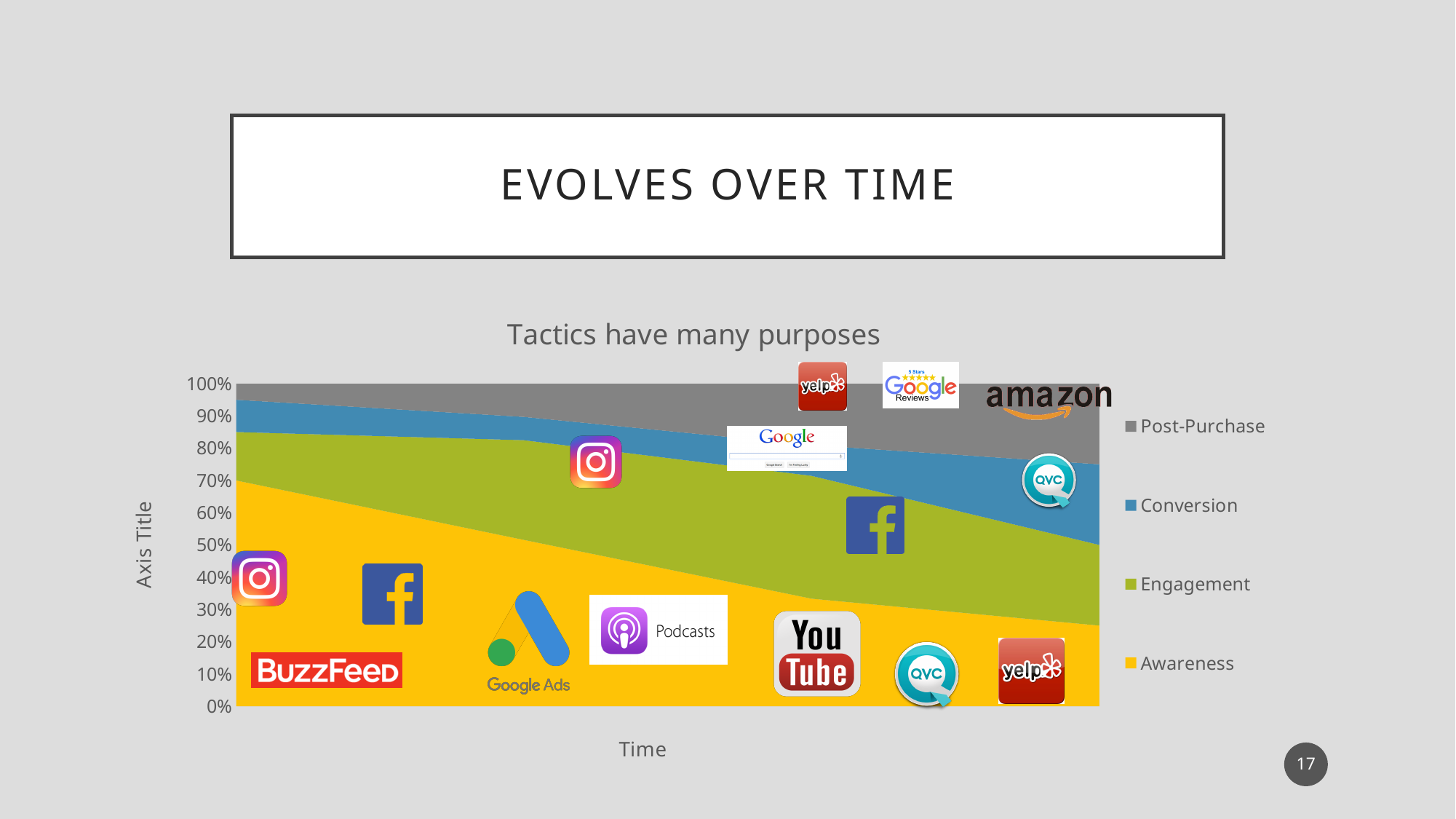
Does the Conversion share rise or fall as you move along the x axis? Rise At the left edge of the chart, is the Awareness share greater or less than 60%? greater At the right edge of the chart, is the Awareness share greater or less than 30%? less Does the Post-Purchase share rise or fall as you move along the x axis? Rise How many series does the chart's legend list? 4 What is the label on the horizontal axis of the chart? Time Does the Awareness share rise or fall as you move along the x axis? Fall At the left edge of the chart, which series has the smallest share? Post-Purchase What kind of chart is shown on the slide? Stacked area chart What is the title of the chart? Tactics have many purposes At the left edge of the chart, which series has the larger share: Awareness or Engagement? Awareness